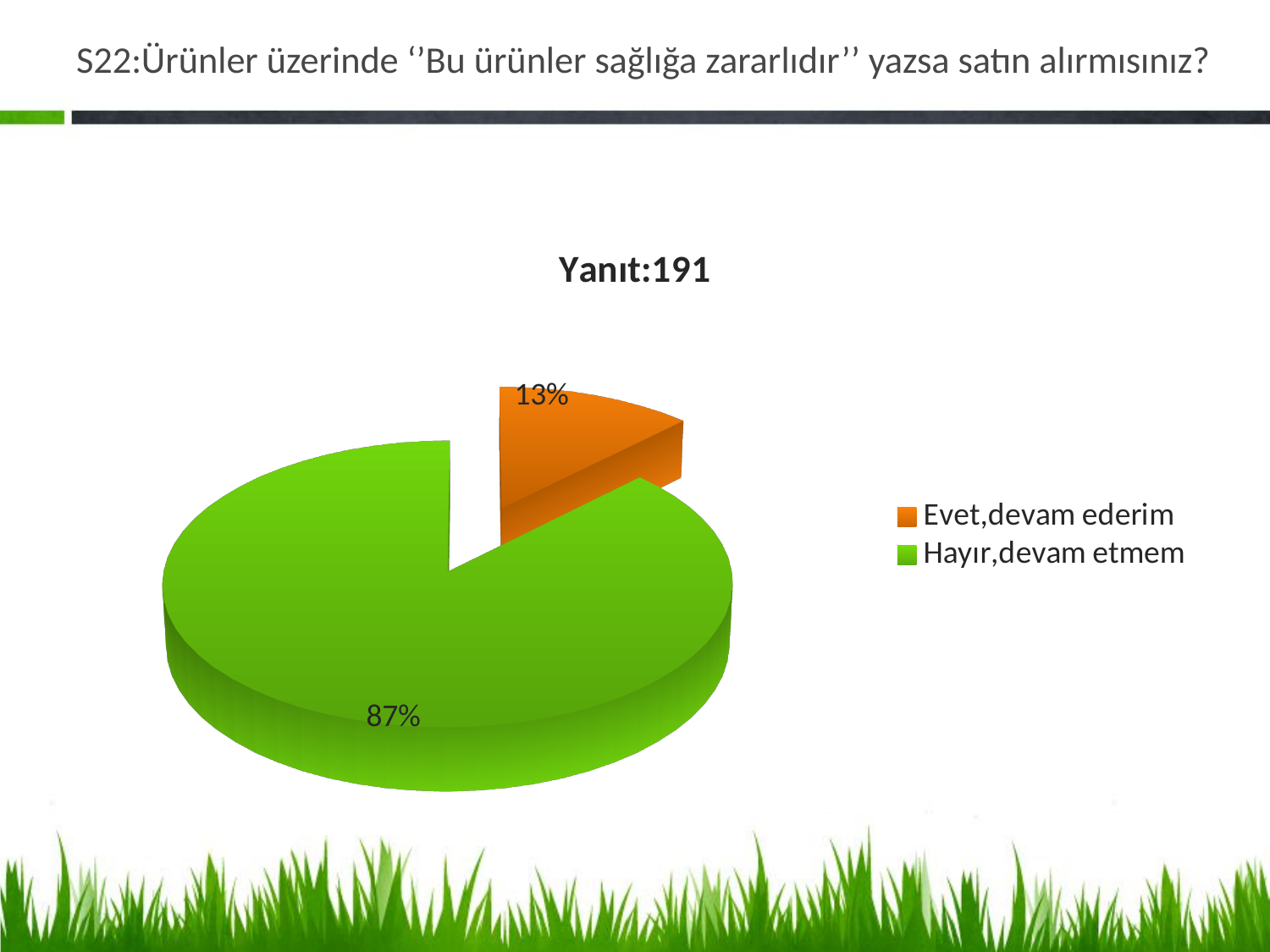
What is the title of the chart? Yanıt:191 Which category has the largest share of the pie? Hayır,devam etmem What type of chart is shown on the slide? pie chart Which is larger: the share for "Evet,devam ederim" or the share for "Hayır,devam etmem"? Hayır,devam etmem How many slices does the pie chart have? 2 What percentage is shown for "Hayır,devam etmem"? 87% What is the difference in percentage points between "Hayır,devam etmem" and "Evet,devam ederim"? 74 What share of the pie does the green slice represent? 87% What colour is the slice for "Evet,devam ederim"? orange Which category has the smallest share of the pie? Evet,devam ederim How many entries does the legend list? 2 What percentage is shown for "Evet,devam ederim"? 13%